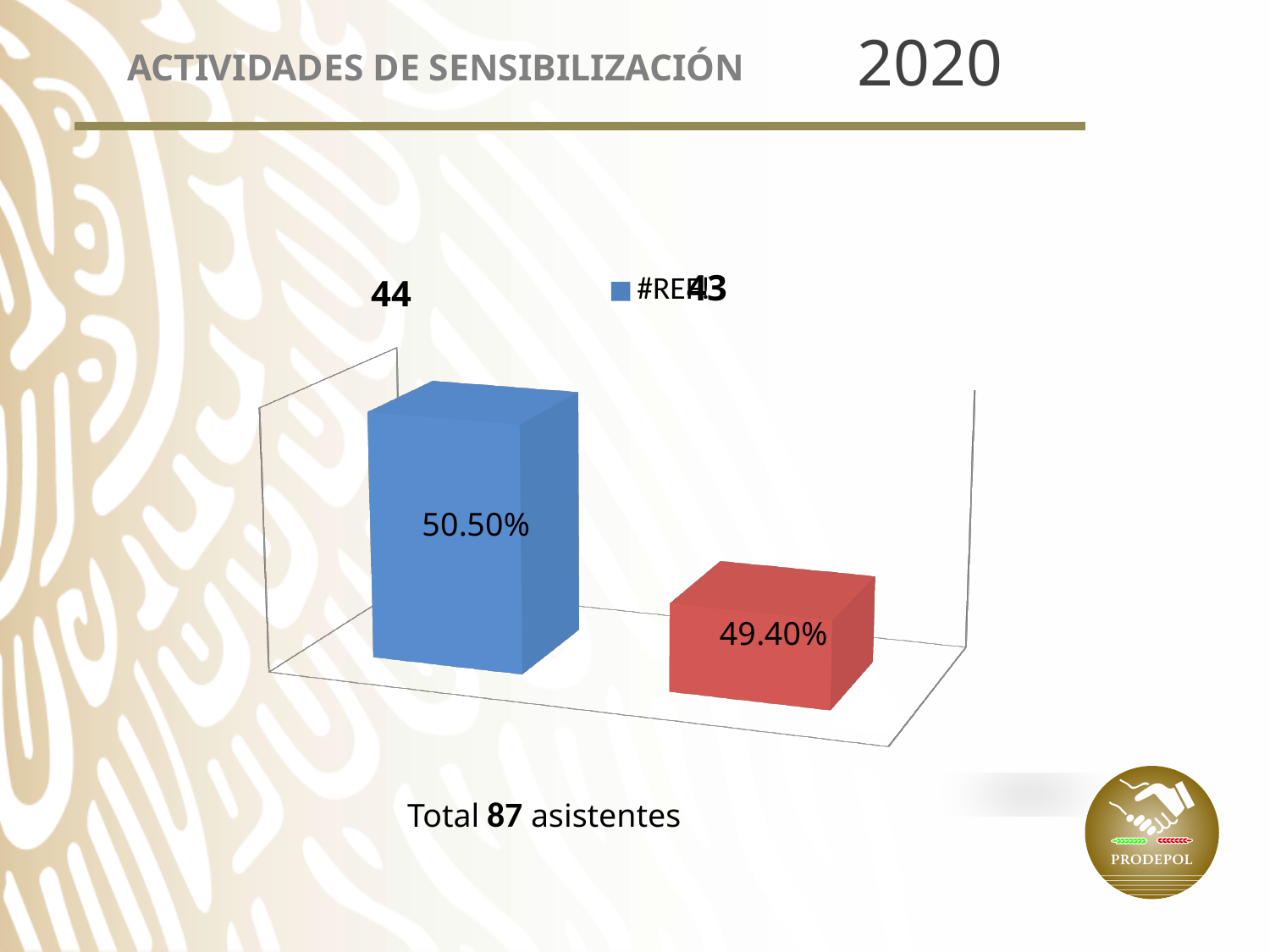
What colour is the taller bar in the chart? blue What total number of attendees (asistentes) is stated below the chart? 87 What is the difference between the percentage on the blue bar and the percentage on the red bar? 1.10% Is the value of the left (blue) bar larger or smaller than the value of the right (red) bar? larger What percentage is printed on the red bar? 49.40% What number is printed above the red bar? 43 What kind of chart is shown on the slide? bar chart What percentage is printed on the blue bar? 50.50% What number is printed above the blue bar? 44 How many bars does the chart show? 2 Which bar has the lower value, the blue one or the red one? the red bar Which bar has the higher value, the blue one or the red one? the blue bar